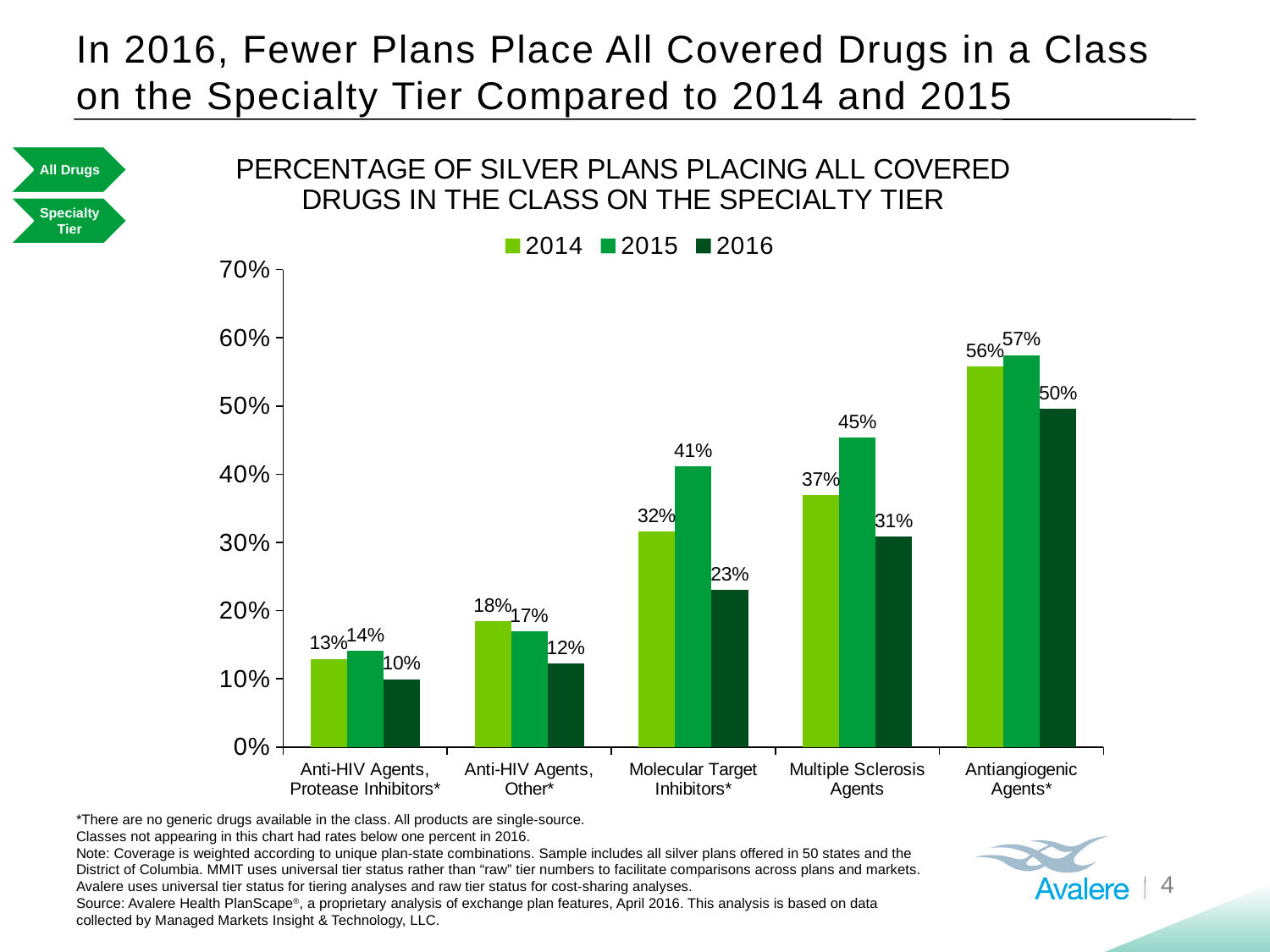
Which drug class has the highest 2016 value? Antiangiogenic Agents* Which drug class has the lowest 2014 value? Anti-HIV Agents, Protease Inhibitors* What is the difference between the 2015 and 2016 values for Molecular Target Inhibitors? 18 percentage points What is the 2016 value for Multiple Sclerosis Agents? 31% What kind of chart is shown on the slide? Bar chart What is the 2014 value for Anti-HIV Agents, Other? 18% How many drug classes are shown on the x axis? 5 Which is larger for Multiple Sclerosis Agents: the 2014 value or the 2015 value? 2015 What percentage of silver plans placed all covered Molecular Target Inhibitors on the specialty tier in 2015? 41% How many series does the legend list? 3 What years are listed in the chart legend? 2014, 2015, 2016 Do the 2016 values rise or fall moving from Anti-HIV Agents, Protease Inhibitors to Antiangiogenic Agents along the x axis? Rise